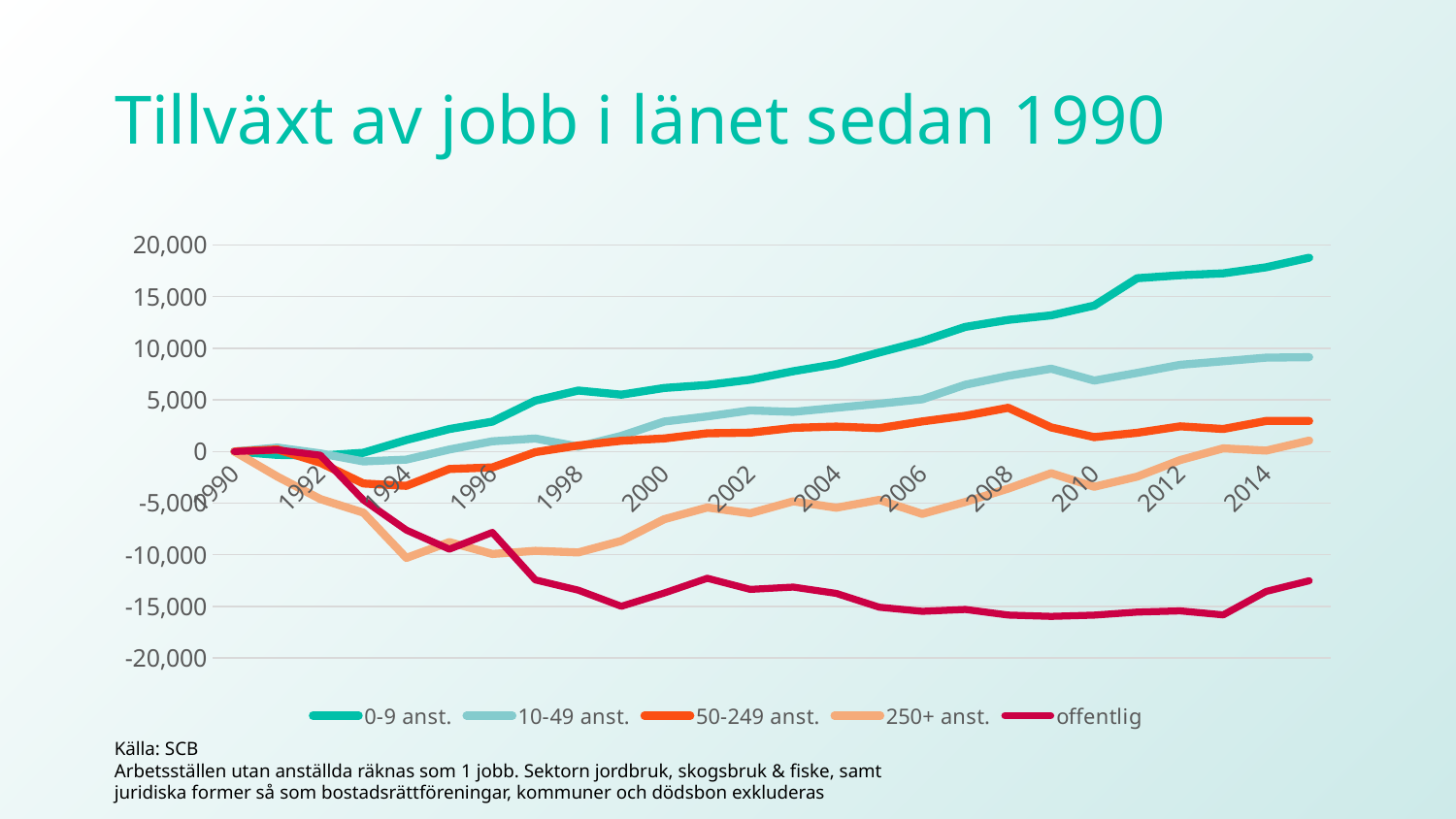
What kind of chart is shown on the slide? line chart Which series is larger in 2008, 0-9 anst. or 50-249 anst.? 0-9 anst. Is the value for 10-49 anst. in 2014 greater or less than 10,000? less What is the title of the chart? Tillväxt av jobb i länet sedan 1990 Is the value for offentlig in 2000 greater or less than -15,000? greater How many series does the legend list? 5 Is the value for 0-9 anst. at the end of the series (2015) greater or less than 15,000? greater What is the value for 0-9 anst. in 1990? 0 Does the 0-9 anst. series generally rise or fall from 1990 to 2015? rise Which series has the lowest value at the right end of the chart (2015)? offentlig Which series has the highest value at the right end of the chart (2015)? 0-9 anst. Which series is drawn in dark red/crimson? offentlig